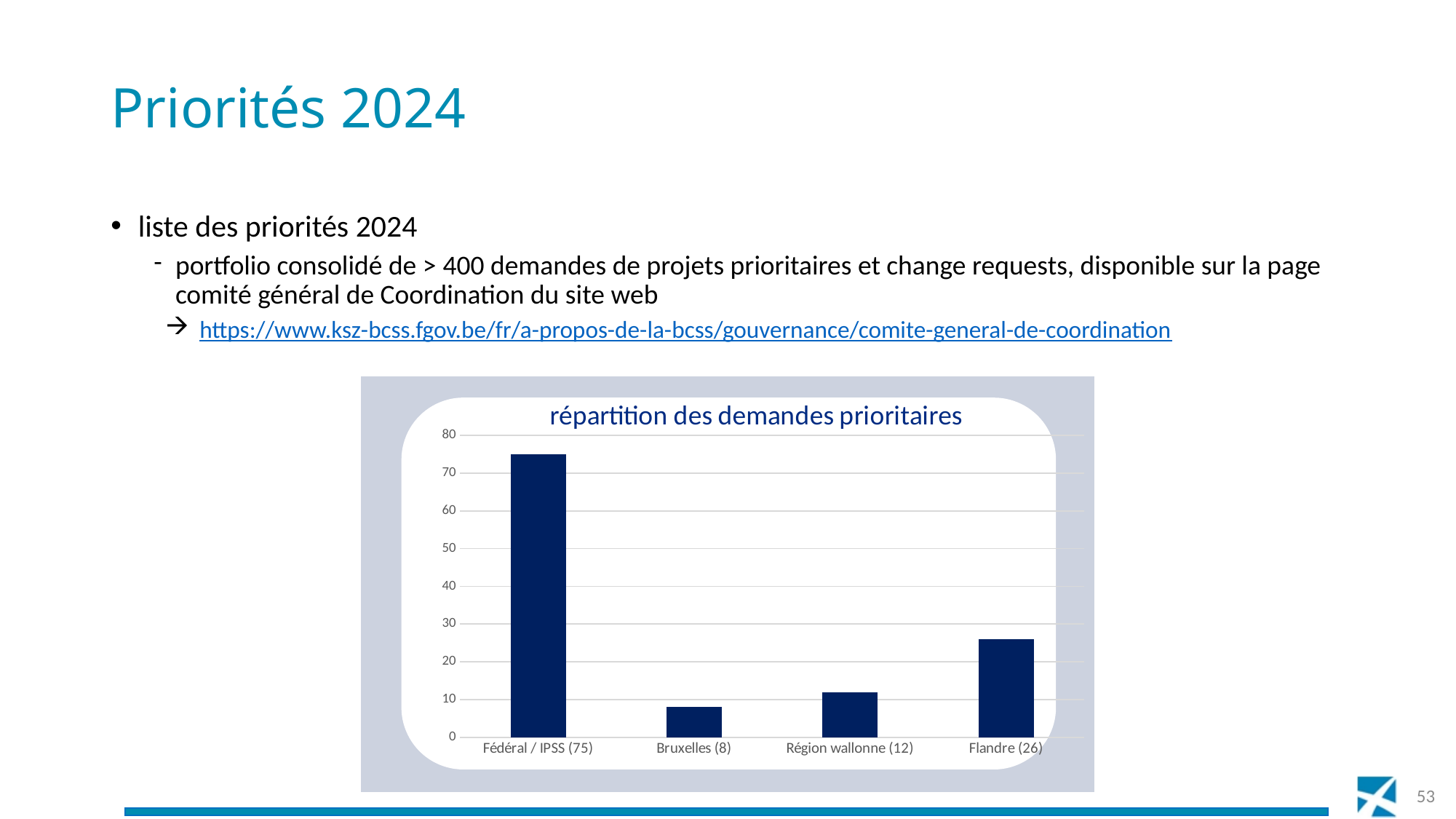
What value is given for Fédéral / IPSS in the chart? 75 Is the value for Fédéral / IPSS greater or less than 70? greater Which category has the lowest value in the chart? Bruxelles What is the title of the chart on the slide? répartition des demandes prioritaires What is the difference between the values for Fédéral / IPSS and Flandre? 49 What kind of chart is shown under the title 'répartition des demandes prioritaires'? bar chart What value is given for Bruxelles in the chart? 8 How many categories are shown on the x axis of the chart? 4 What value is given for Flandre in the chart? 26 What value is given for Région wallonne in the chart? 12 Which is larger, the value for Flandre or the value for Région wallonne? Flandre Which category has the highest value in the chart? Fédéral / IPSS